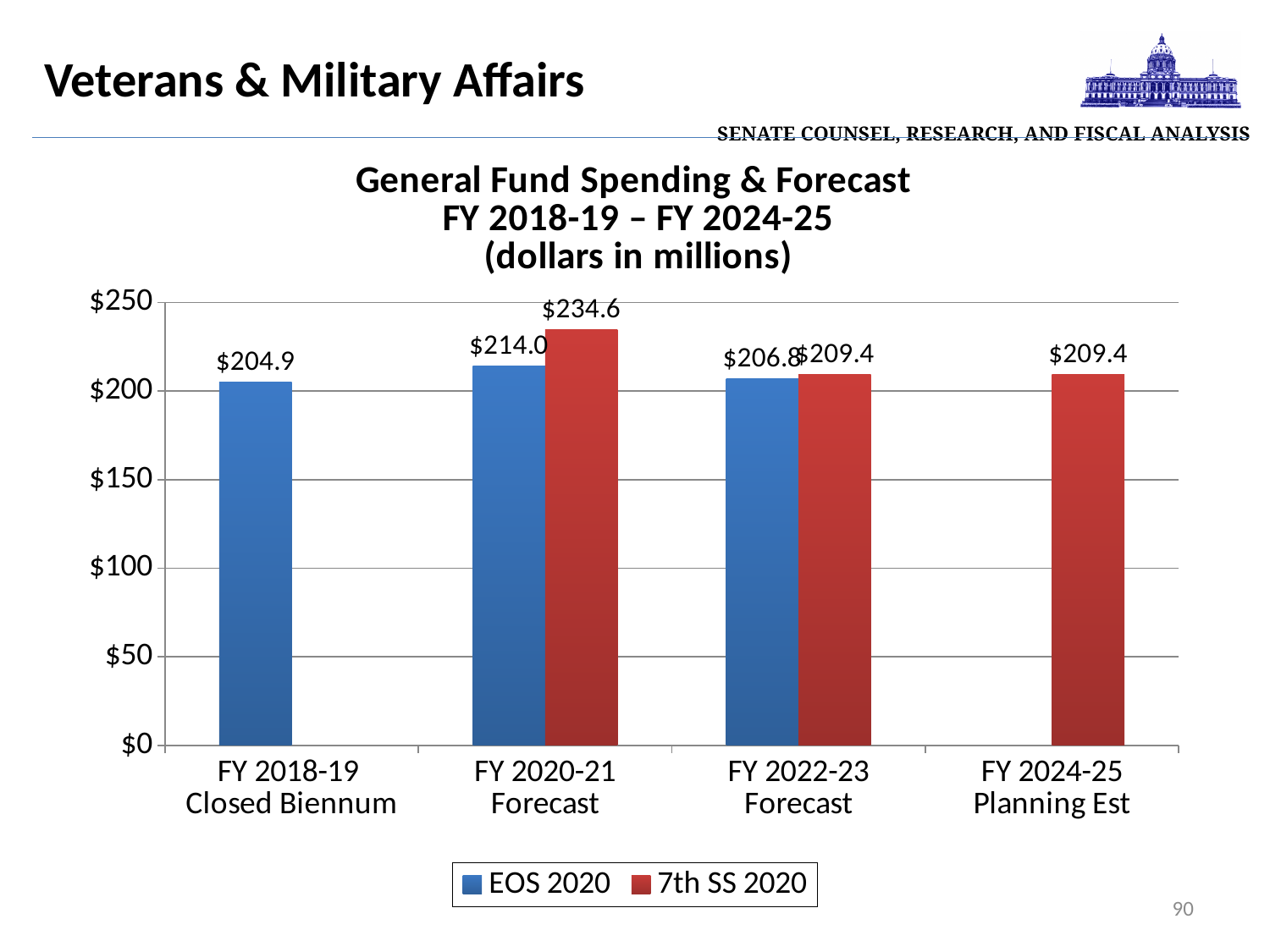
How many series does the legend list? 2 What is the EOS 2020 value for FY 2018-19 Closed Biennum? $204.9 Which category has the highest 7th SS 2020 value? FY 2020-21 Forecast Is the 7th SS 2020 value for FY 2020-21 Forecast greater or less than $200? greater What is the 7th SS 2020 value for FY 2024-25 Planning Est? $209.4 What is the 7th SS 2020 value for FY 2020-21 Forecast? $234.6 For FY 2022-23 Forecast, which is larger: the EOS 2020 value or the 7th SS 2020 value? 7th SS 2020 What kind of chart is shown on the slide? bar chart How many categories are shown on the x axis? 4 What is the EOS 2020 value for FY 2022-23 Forecast? $206.8 Which category has the lowest EOS 2020 value? FY 2018-19 Closed Biennum What is the difference between the 7th SS 2020 and EOS 2020 values for FY 2020-21 Forecast? $20.6